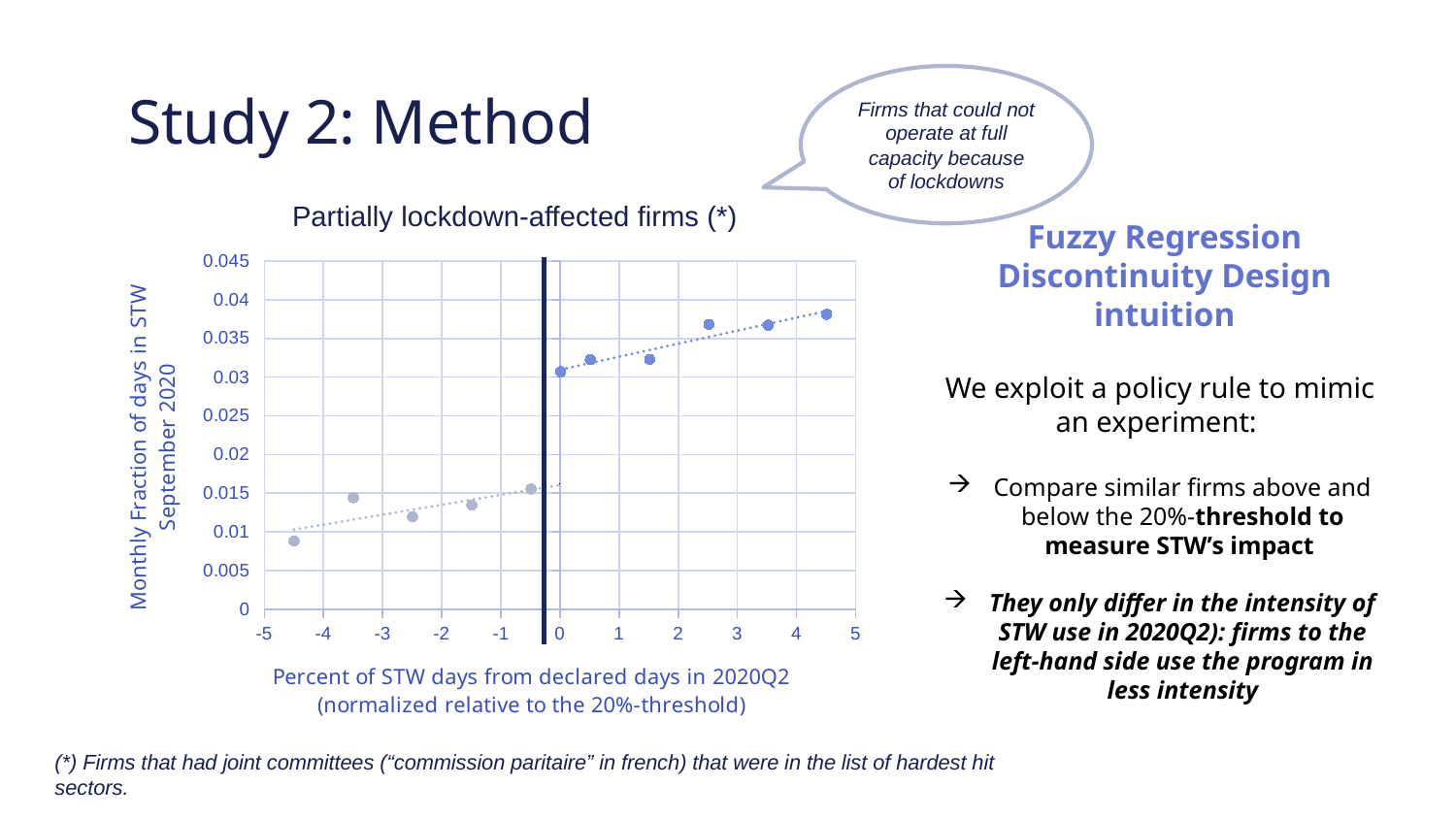
Which point has the lowest value in the chart? The leftmost point, at x = -4.5 Is the value for the point at x = 0 greater or less than 0.025? greater What kind of chart is shown on the slide? Scatter chart What is the label of the vertical axis of the chart? Monthly Fraction of days in STW September 2020 Is the value for the point at x = 2.5 greater or less than 0.035? greater What is the title of the chart? Partially lockdown-affected firms (*) Which is larger: the value of the point just left of the threshold line (x = -0.5) or the point just right of it (x = 0)? The point at x = 0 Do the plotted values generally rise or fall as the x-axis value increases? Rise Is the value for the point at x = 4.5 (the rightmost point) greater or less than 0.035? greater